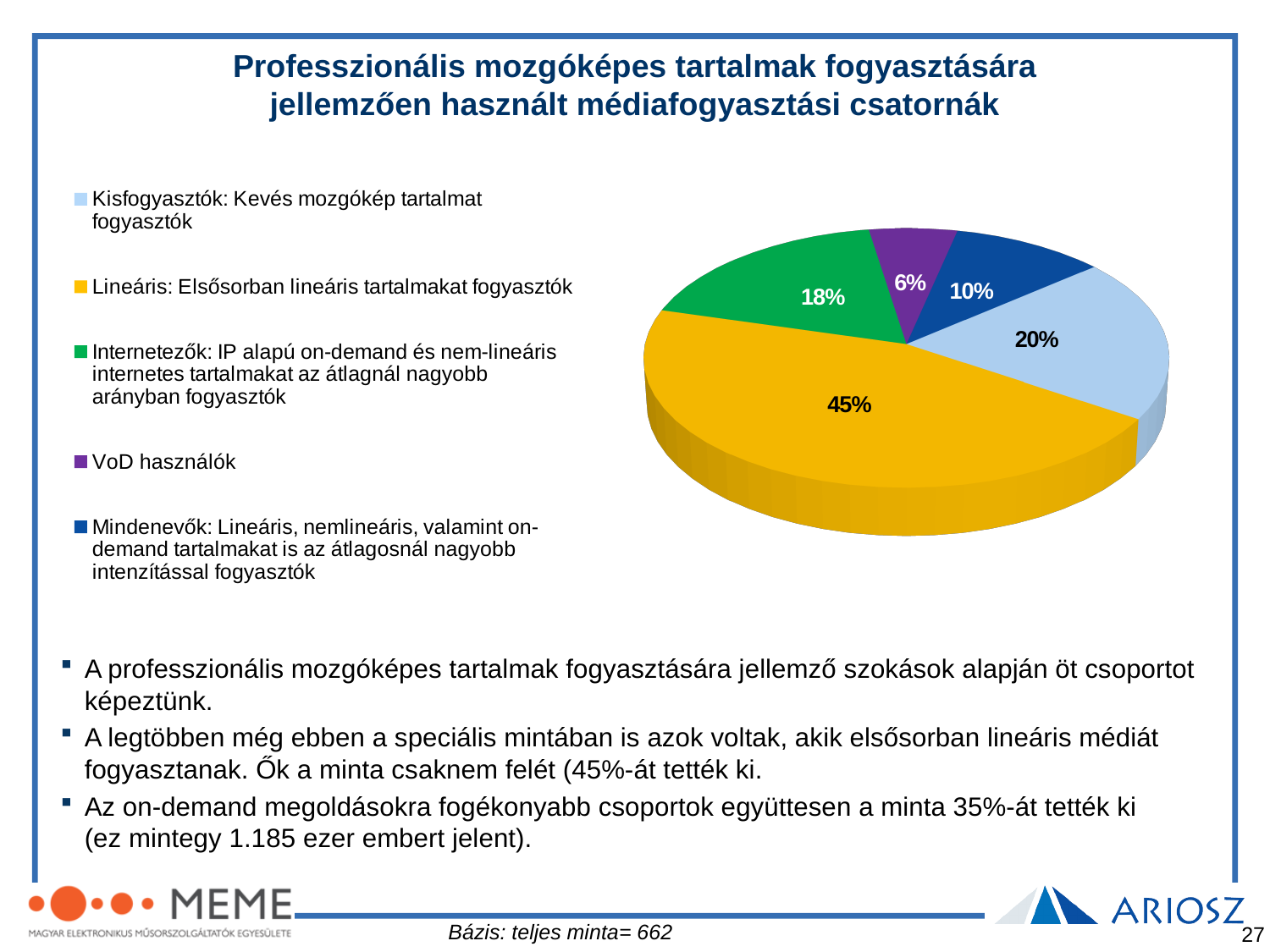
What kind of chart is shown on the slide? pie chart How many slices does the pie chart have? 5 Which is larger, the share for 'Internetezők' or the share for 'Mindenevők'? Internetezők Which group has the largest share of the pie? Lineáris What colour is the slice for 'Internetezők'? green What is the value shown for 'Mindenevők'? 10% Which group has the smallest share of the pie? VoD használók What is the value shown for 'VoD használók'? 6% What is the difference in percentage points between the 'Lineáris' and 'Kisfogyasztók' shares? 25 What share of the pie does the 'Lineáris' group represent? 45% What is the value shown for 'Kisfogyasztók'? 20% What is the value shown for 'Internetezők'? 18%